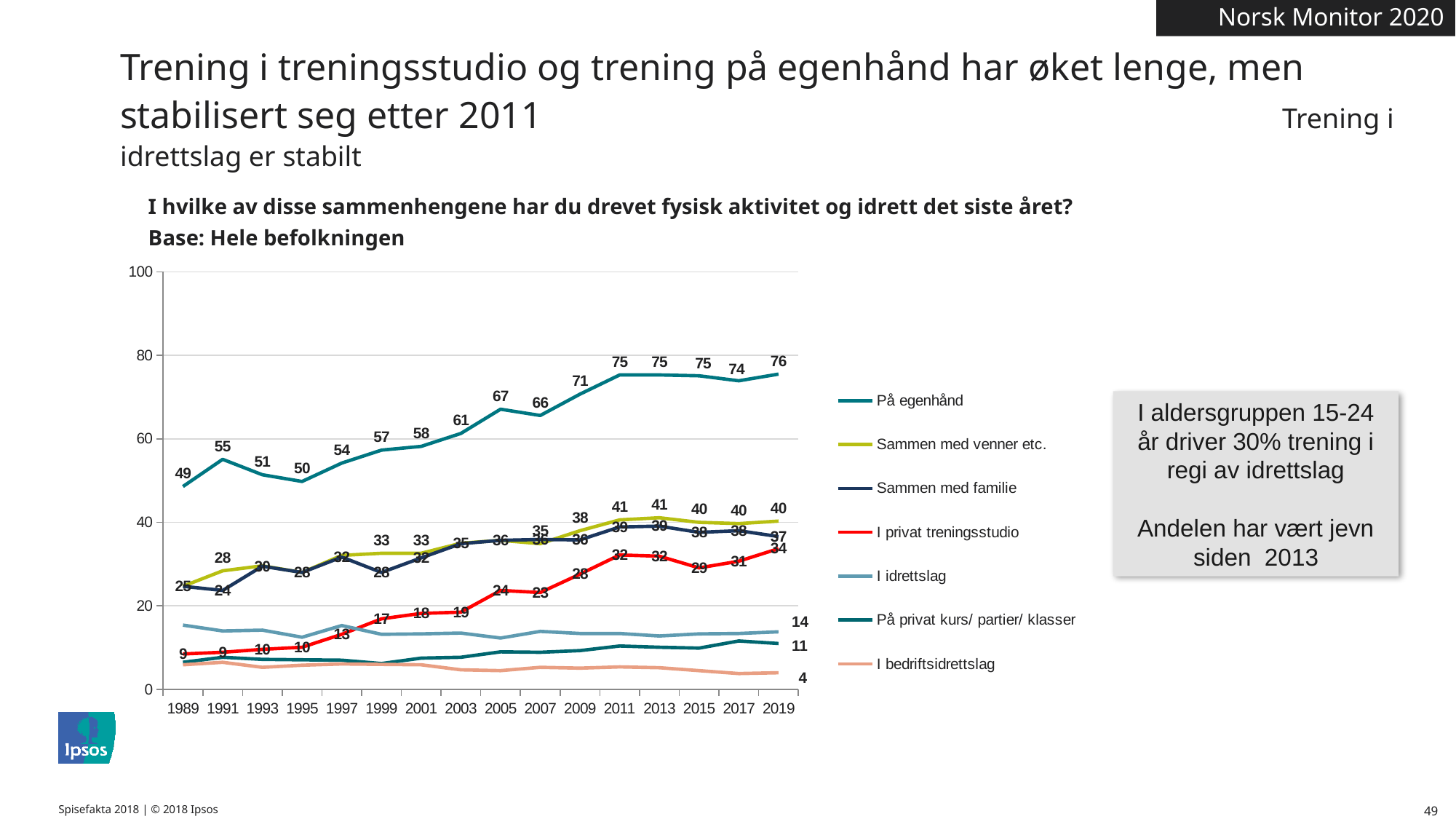
Which series has the lowest value in 2019? I bedriftsidrettslag What kind of chart is shown on the slide? line chart Is the value for 'I idrettslag' in 1989 greater or less than 20? less What is the value for 'I idrettslag' in 2019? 14 In which year does 'På egenhånd' reach its highest value? 2019 How many series does the legend list? 7 What is the difference between the 'På egenhånd' values in 2019 and 1989? 27 What is the value for 'I privat treningsstudio' in 2019? 34 What is the value for 'På egenhånd' in 1989? 49 What is the value for 'I bedriftsidrettslag' in 2019? 4 In 2019, which is larger: 'På egenhånd' or 'Sammen med venner etc.'? På egenhånd What is the value for 'På egenhånd' in 2019? 76